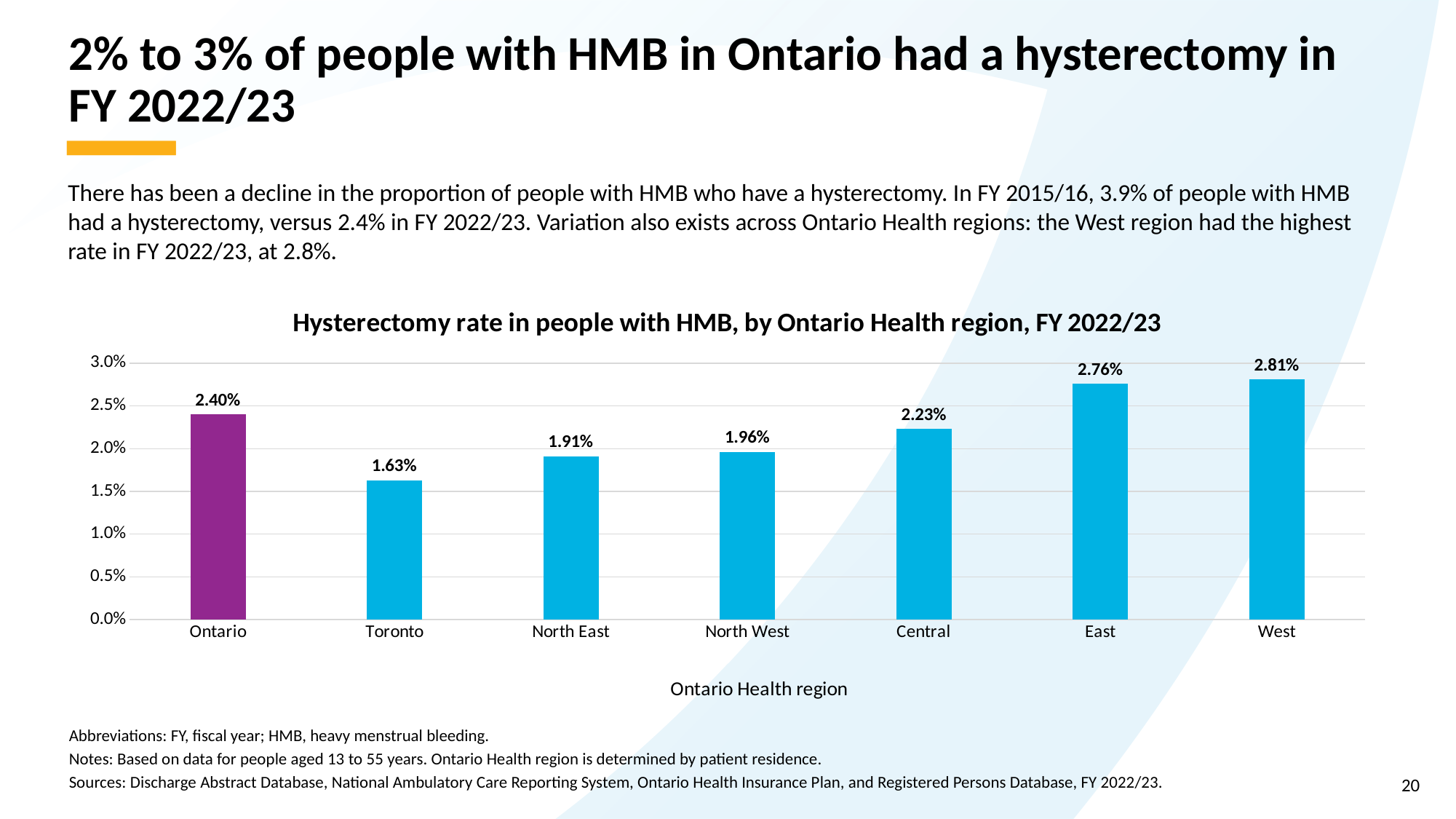
What is the difference between the West and Toronto hysterectomy rates? 1.18% What type of chart is shown on the slide? Bar chart What is the hysterectomy rate for Ontario overall? 2.40% What is the hysterectomy rate for the Toronto region? 1.63% Which has a higher hysterectomy rate, North East or North West? North West What is the difference between the East and Central hysterectomy rates? 0.53% Which region has the highest hysterectomy rate? West Is the value for Central greater or less than 2.0%? greater Which bar is coloured differently (purple) from the others? Ontario What is the hysterectomy rate for the Central region? 2.23% Which region has the lowest hysterectomy rate? Toronto How many bars are shown in the chart? 7